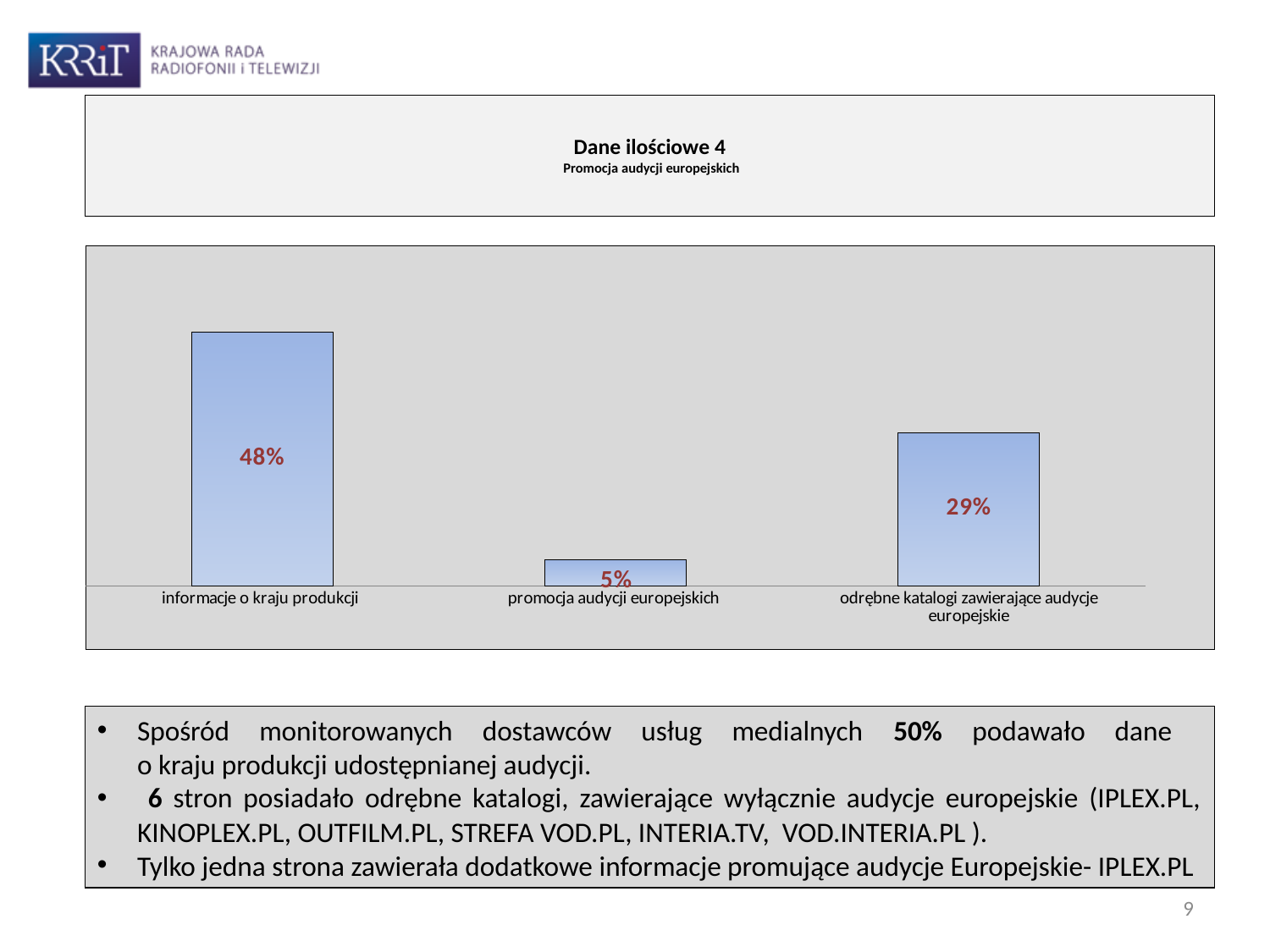
What kind of chart is shown on the slide? bar chart What is the difference between the values for "informacje o kraju produkcji" and "odrębne katalogi zawierające audycje europejskie"? 19% What is the title of the slide above the chart? Dane ilościowe 4 What is the value for "informacje o kraju produkcji"? 48% Which category has the highest value? informacje o kraju produkcji What is the value for "promocja audycji europejskich"? 5% Which category has the lowest value? promocja audycji europejskich How many categories are shown in the chart? 3 What is the value for "odrębne katalogi zawierające audycje europejskie"? 29% Which is larger: the value for "promocja audycji europejskich" or for "odrębne katalogi zawierające audycje europejskie"? odrębne katalogi zawierające audycje europejskie What is the subtitle printed under the slide title? Promocja audycji europejskich What is the difference between the values for "odrębne katalogi zawierające audycje europejskie" and "promocja audycji europejskich"? 24%